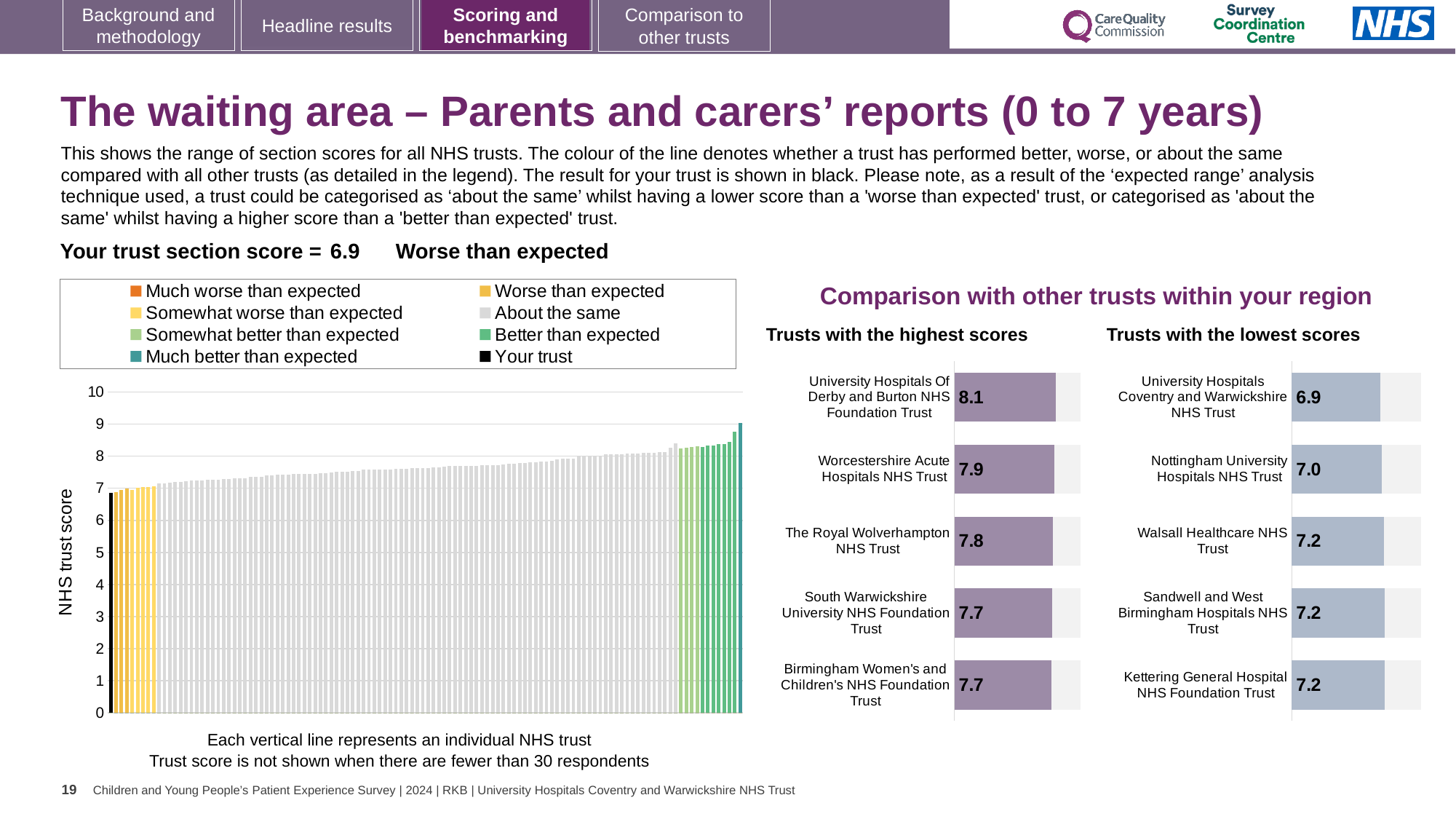
How many trusts are shown in the 'Trusts with the highest scores' chart? 5 In the 'Trusts with the highest scores' chart, what is the score for Worcestershire Acute Hospitals NHS Trust? 7.9 In the 'Trusts with the highest scores' chart, which trust has the highest score? University Hospitals Of Derby and Burton NHS Foundation Trust In the 'Trusts with the lowest scores' chart, what is the score for Nottingham University Hospitals NHS Trust? 7.0 What is the y-axis label of the left-hand chart of all NHS trusts? NHS trust score What kind of chart is the large chart on the left showing all NHS trust scores? bar chart In the left-hand chart of all NHS trusts, do the scores rise or fall from left to right? rise How many entries does the legend above the left-hand chart list? 8 In the 'Trusts with the lowest scores' chart, what is the difference between the scores of Kettering General Hospital NHS Foundation Trust and University Hospitals Coventry and Warwickshire NHS Trust? 0.3 In the 'Trusts with the lowest scores' chart, which trust has the lowest score? University Hospitals Coventry and Warwickshire NHS Trust In the 'Trusts with the highest scores' chart, what is the difference between the scores of University Hospitals Of Derby and Burton NHS Foundation Trust and The Royal Wolverhampton NHS Trust? 0.3 In the 'Trusts with the lowest scores' chart, which has the higher score: Walsall Healthcare NHS Trust or Nottingham University Hospitals NHS Trust? Walsall Healthcare NHS Trust